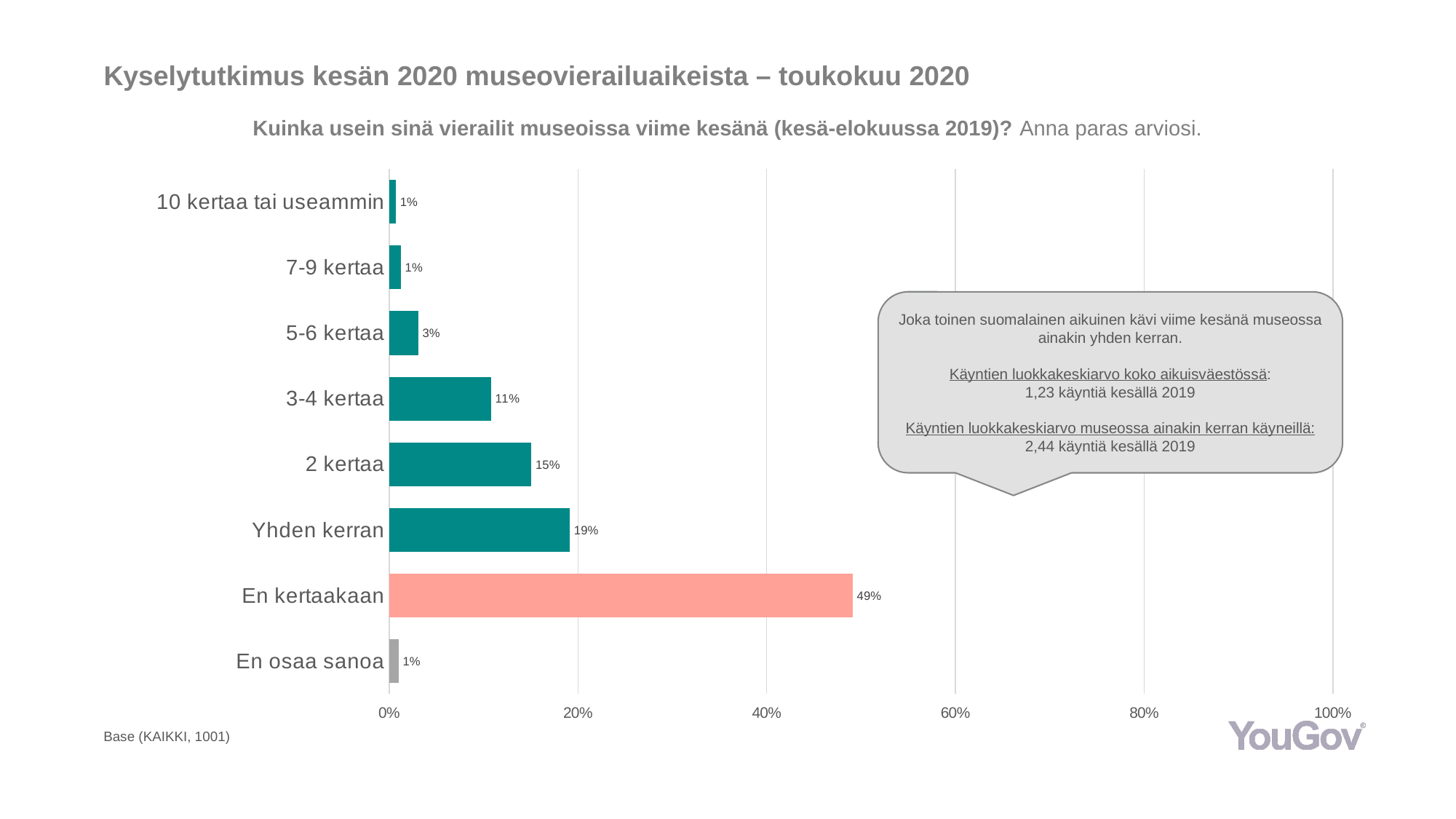
Which category's bar is coloured differently (pink/salmon) from the teal bars? En kertaakaan What is the value for "Yhden kerran"? 19% Which category has the highest value? En kertaakaan What kind of chart is shown on the slide? Bar chart What is the value for "5-6 kertaa"? 3% What is the difference between the values for "En kertaakaan" and "Yhden kerran"? 30% What percentage of respondents answered "En kertaakaan"? 49% How many categories are shown on the chart? 8 Is the value for "En kertaakaan" greater or less than 40%? greater Which is larger, the value for "2 kertaa" or the value for "5-6 kertaa"? 2 kertaa What is the difference between the values for "2 kertaa" and "3-4 kertaa"? 4% What is the value for "3-4 kertaa"? 11%